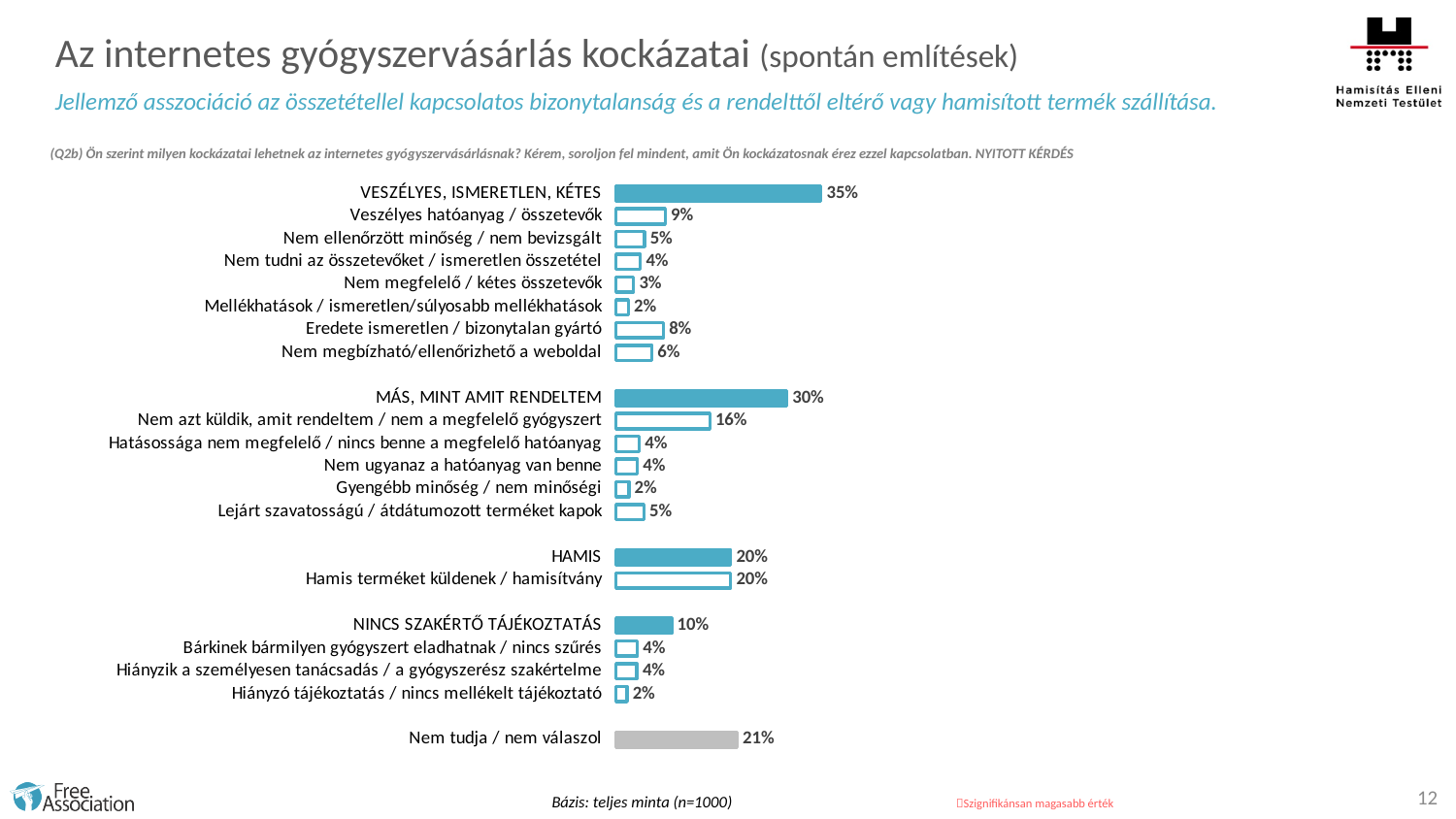
Which category has the highest value in the chart? VESZÉLYES, ISMERETLEN, KÉTES What is the value for "Nem tudja / nem válaszol"? 21% What is the difference between the values for "Veszélyes hatóanyag / összetevők" and "Nem megfelelő / kétes összetevők"? 6% What is the value for "Nem azt küldik, amit rendeltem / nem a megfelelő gyógyszert"? 16% What is the difference between the values for "VESZÉLYES, ISMERETLEN, KÉTES" and "MÁS, MINT AMIT RENDELTEM"? 5% What is the base (sample size) stated at the bottom of the slide? n=1000 What is the value for "VESZÉLYES, ISMERETLEN, KÉTES"? 35% Which is larger, the value for "HAMIS" or the value for "NINCS SZAKÉRTŐ TÁJÉKOZTATÁS"? HAMIS What is the value for "MÁS, MINT AMIT RENDELTEM"? 30% What kind of chart is shown on the slide? bar chart What is the value for "Eredete ismeretlen / bizonytalan gyártó"? 8% How many bars are plotted in the chart? 21